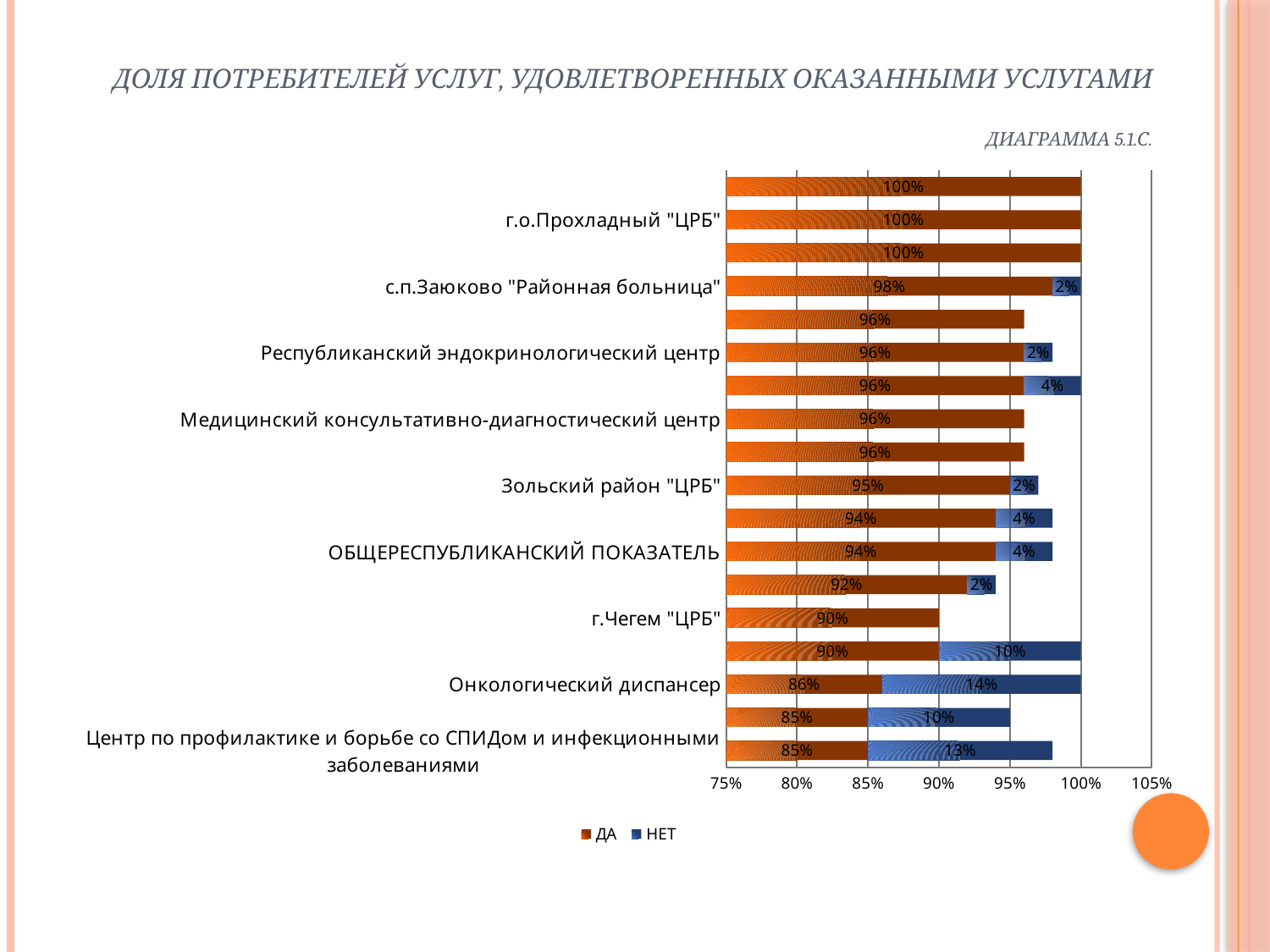
What kind of chart is shown on the slide? bar chart What are the two series named in the legend? ДА and НЕТ What is the difference between the ДА values for Зольский район "ЦРБ" and г.Чегем "ЦРБ"? 5% What is the diagram number given on the slide? ДИАГРАММА 5.1.С. How many series does the legend list? 2 Which has a larger ДА value, Медицинский консультативно-диагностический центр or Онкологический диспансер? Медицинский консультативно-диагностический центр What is the НЕТ value for Республиканский эндокринологический центр? 2% What is the НЕТ value for Онкологический диспансер? 14% What is the ДА value for с.п.Заюково "Районная больница"? 98% What is the ДА value for г.о.Прохладный "ЦРБ"? 100% What is the ДА value for Центр по профилактике и борьбе со СПИДом и инфекционными заболеваниями? 85% What is the ДА value for ОБЩЕРЕСПУБЛИКАНСКИЙ ПОКАЗАТЕЛЬ? 94%